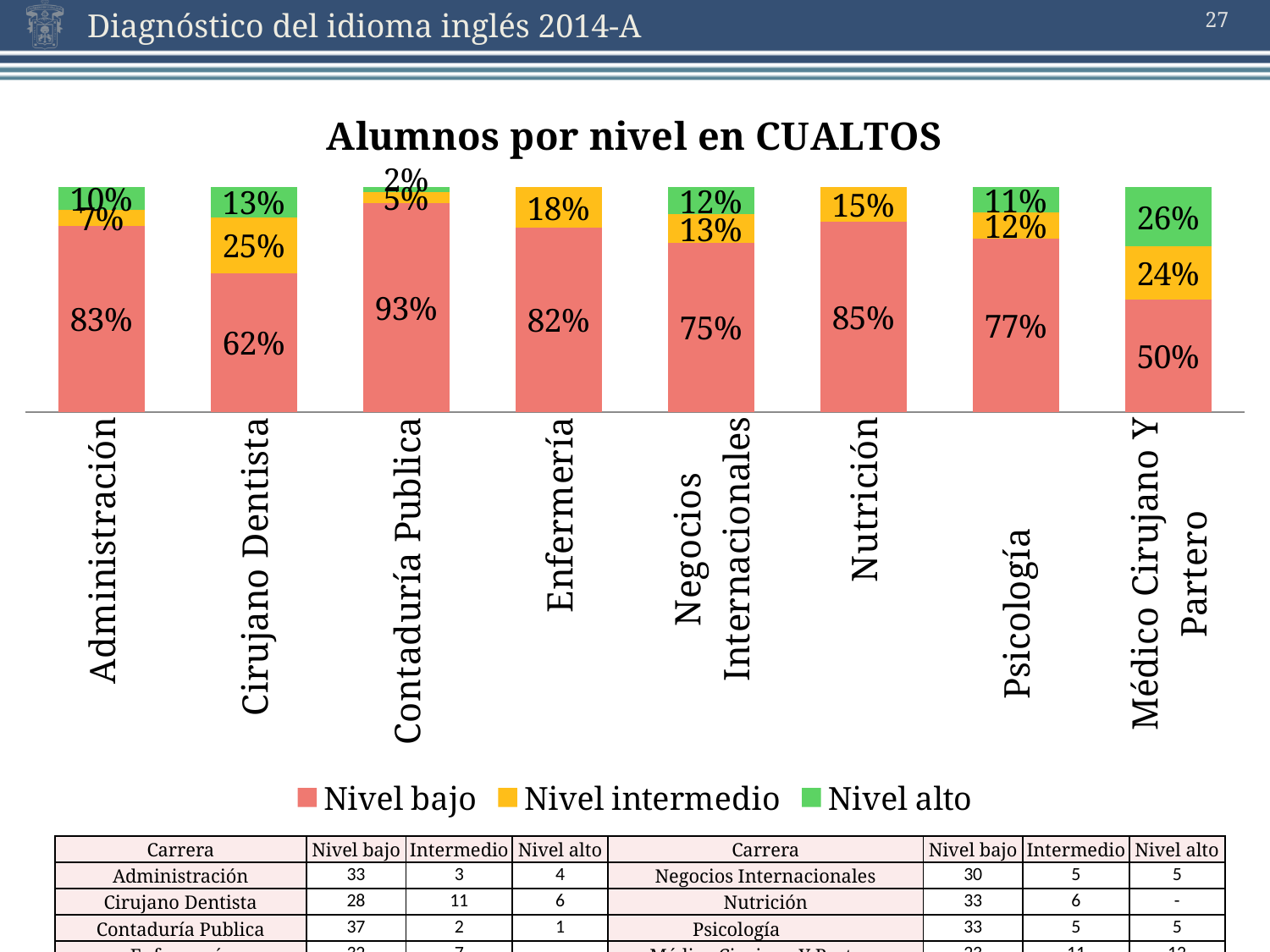
How many careers are shown on the x axis of the chart? 8 Which career has the highest Nivel bajo share? Contaduría Publica What kind of chart is shown on the slide? Stacked bar chart What is the Nivel bajo value for Negocios Internacionales? 75% Which is larger, the Nivel intermedio value for Enfermería or for Nutrición? Enfermería How many series does the legend list? 3 What is the Nivel bajo value for Contaduría Publica? 93% Which career has the lowest Nivel bajo share? Médico Cirujano Y Partero What is the Nivel intermedio value for Cirujano Dentista? 25% What is the difference between the Nivel bajo values for Nutrición and Psicología? 8% What is the title of the chart? Alumnos por nivel en CUALTOS What is the Nivel alto value for Médico Cirujano Y Partero? 26%